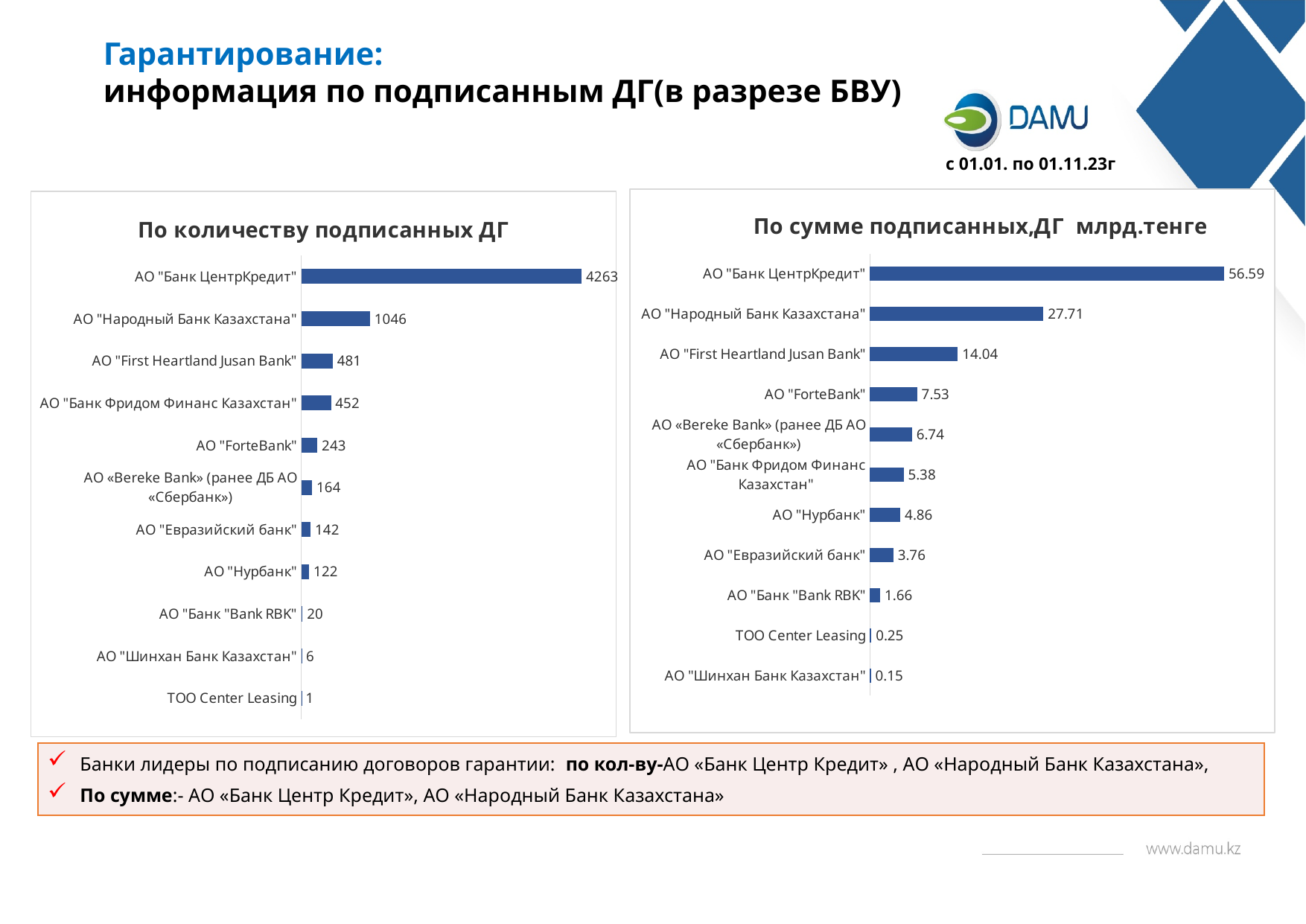
In the chart "По количеству подписанных ДГ", what is the value for АО "Банк ЦентрКредит"? 4263 What is the title of the chart on the left side of the slide? По количеству подписанных ДГ In the chart "По количеству подписанных ДГ", which bank has the lowest value? ТОО Center Leasing In the chart "По количеству подписанных ДГ", what is the value for АО "ForteBank"? 243 What type of chart is the chart on the right side of the slide? Bar chart In the chart "По количеству подписанных ДГ", how many banks are listed? 11 In the chart "По количеству подписанных ДГ", what is the difference between АО "First Heartland Jusan Bank" and АО "Банк Фридом Финанс Казахстан"? 29 In the chart "По сумме подписанных,ДГ млрд.тенге", what is the value for АО "Нурбанк"? 4.86 In the chart "По сумме подписанных,ДГ млрд.тенге", which bank has the highest value? АО "Банк ЦентрКредит" In the chart "По сумме подписанных,ДГ млрд.тенге", what is the value for АО "Народный Банк Казахстана"? 27.71 In the chart "По сумме подписанных,ДГ млрд.тенге", which is larger: АО "ForteBank" or АО "Евразийский банк"? АО "ForteBank" In the chart "По сумме подписанных,ДГ млрд.тенге", what is the difference between АО "Банк ЦентрКредит" and АО "Народный Банк Казахстана"? 28.88